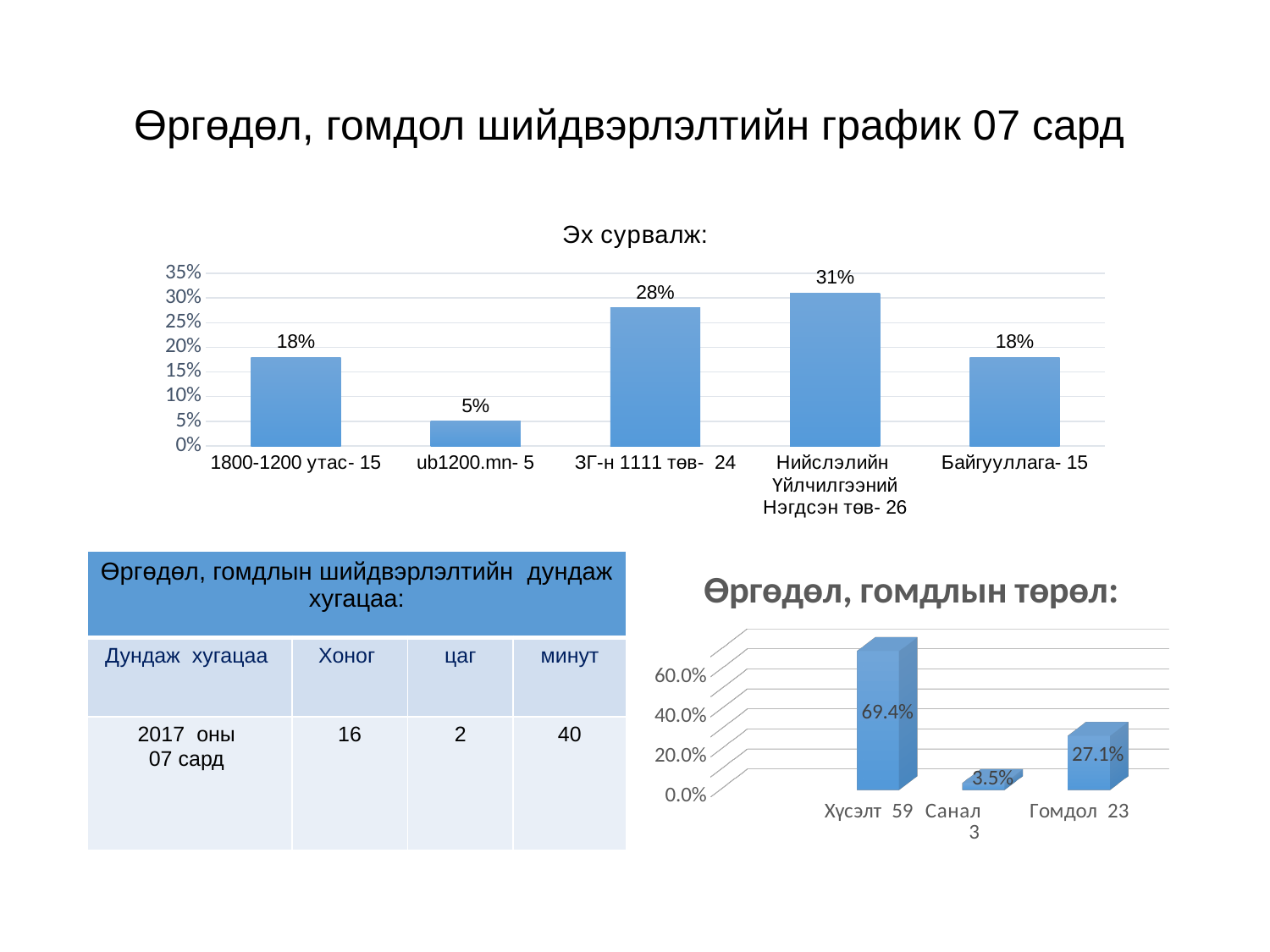
In the 'Өргөдөл, гомдлын төрөл:' chart, which is larger, 'Гомдол 23' or 'Санал 3'? Гомдол 23 In the 'Эх сурвалж:' chart, which category has the lowest value? ub1200.mn- 5 In the 'Өргөдөл, гомдлын төрөл:' chart, what is the value for 'Хүсэлт 59'? 69.4% In the 'Эх сурвалж:' chart, what is the difference between the values for 'Нийслэлийн Үйлчилгээний Нэгдсэн төв- 26' and 'ЗГ-н 1111 төв- 24'? 3% In the 'Эх сурвалж:' chart, what is the value for 'ЗГ-н 1111 төв- 24'? 28% What kind of chart is the 'Өргөдөл, гомдлын төрөл:' chart? bar chart In the 'Өргөдөл, гомдлын төрөл:' chart, what is the value for 'Санал 3'? 3.5% In the 'Эх сурвалж:' chart, what is the value for 'ub1200.mn- 5'? 5% In the 'Эх сурвалж:' chart, how many categories are shown? 5 In the 'Эх сурвалж:' chart, is the value for 'Байгууллага- 15' greater or less than 20%? less In the 'Эх сурвалж:' chart, which category has the highest value? Нийслэлийн Үйлчилгээний Нэгдсэн төв- 26 In the 'Өргөдөл, гомдлын төрөл:' chart, what is the difference between the values for 'Хүсэлт 59' and 'Гомдол 23'? 42.3%